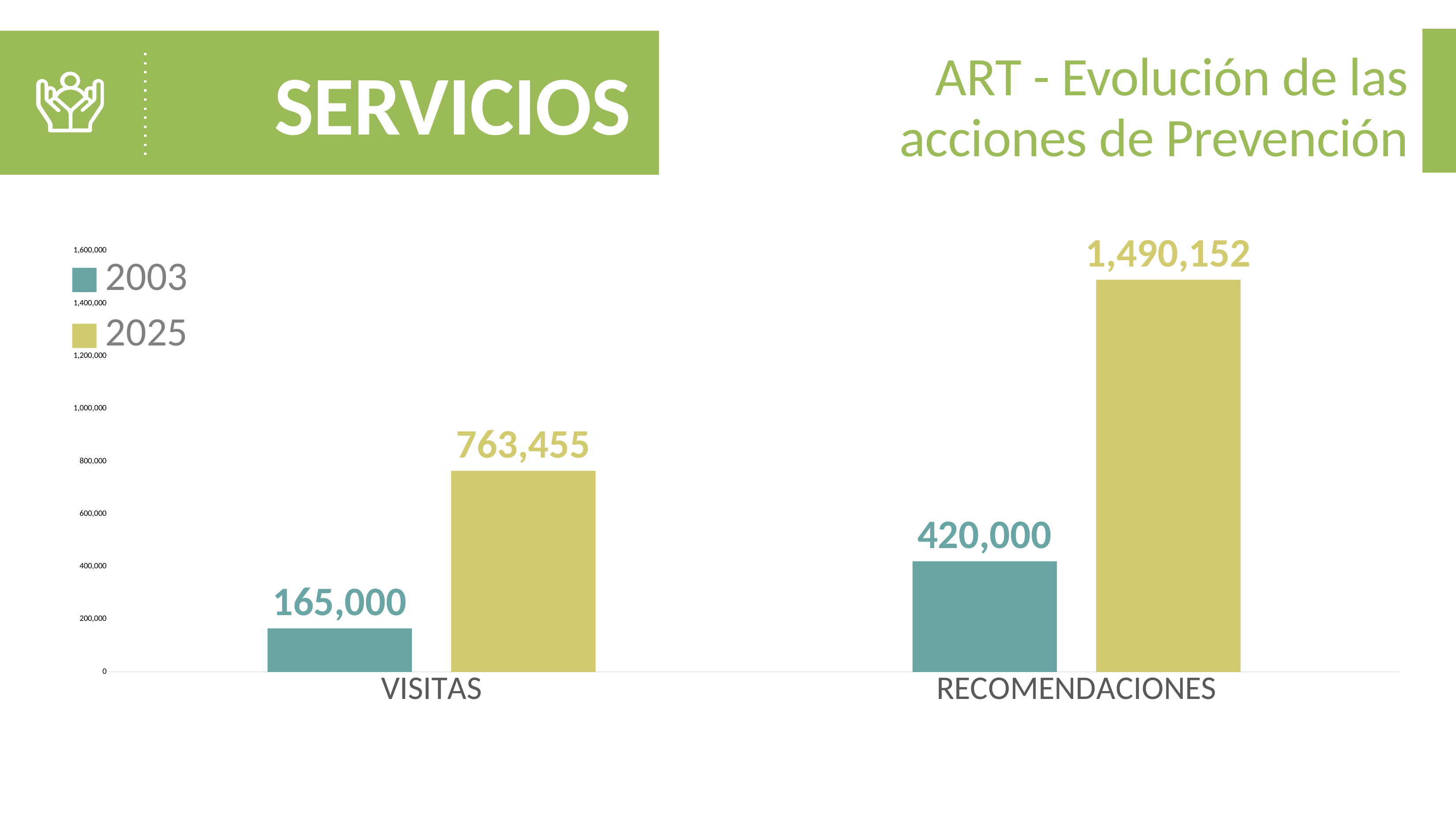
What is the difference between the 2025 and 2003 values for RECOMENDACIONES? 1,070,152 What is the difference between the 2025 and 2003 values for VISITAS? 598,455 How many series does the legend list? 2 What is the value for RECOMENDACIONES in 2025? 1,490,152 What is the value for VISITAS in 2003? 165,000 What kind of chart is shown on the slide? Bar chart Which category has the highest value in 2025? RECOMENDACIONES Which category has the lowest value in 2003? VISITAS Which is larger: VISITAS in 2025 or RECOMENDACIONES in 2003? VISITAS in 2025 How many categories are shown on the x axis? 2 What is the value for VISITAS in 2025? 763,455 What is the value for RECOMENDACIONES in 2003? 420,000